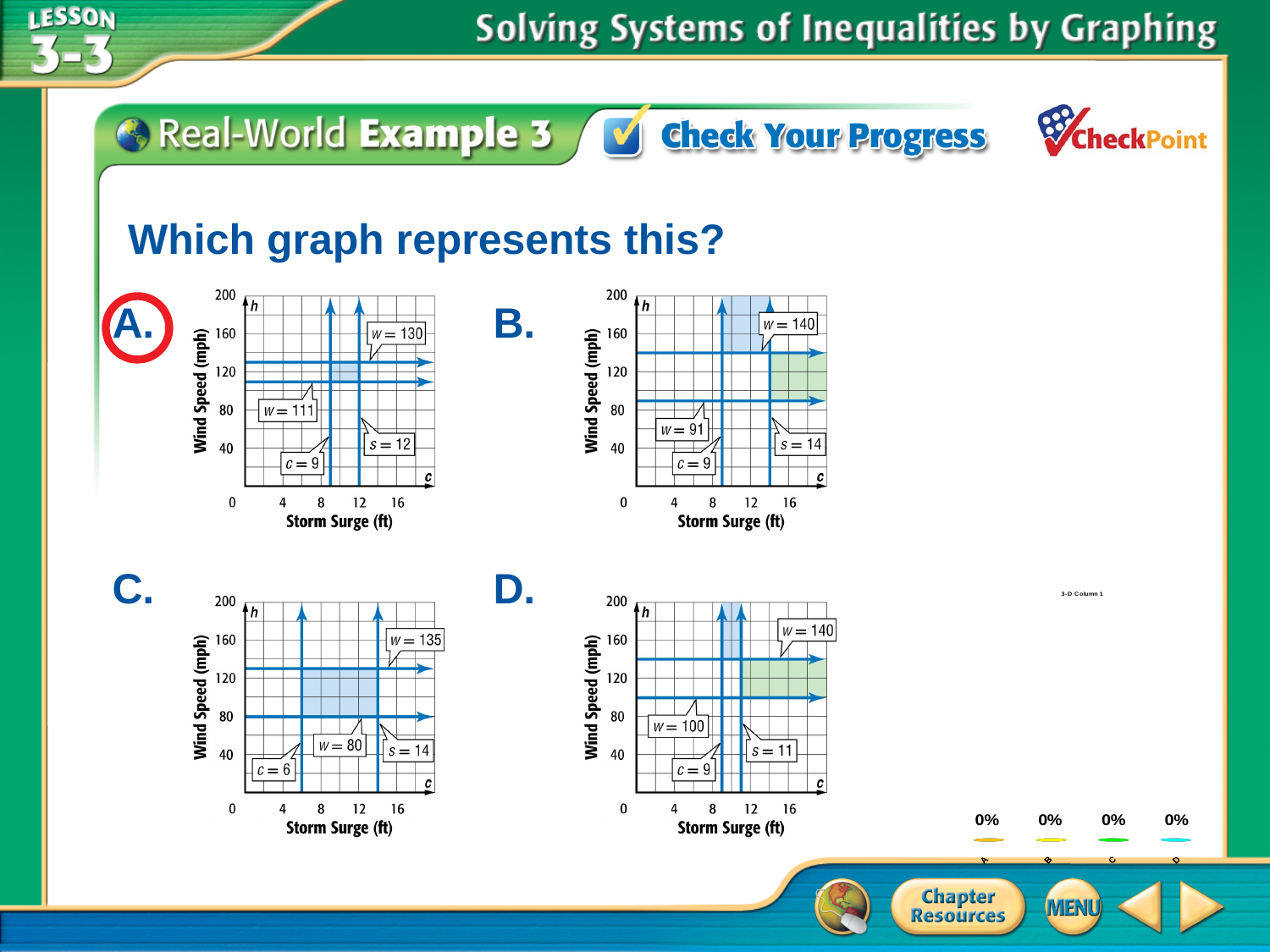
In graph D, what value of s is labeled on the right vertical line? 11 What is the label on the vertical axis of graph A? Wind Speed (mph) What is the title printed above the small bar chart at the bottom right? 3-D Column 1 In graph B, what value of s is labeled on the right vertical line? 14 In graph D, what value of w is labeled on the lower horizontal line? 100 In graph C, what value of c is labeled on the left vertical line? 6 In graph A, what value of w is labeled on the lower horizontal line? 111 In graph A, what value of w is labeled on the upper horizontal line? 130 In the small bar chart at the bottom right, what is the value shown for category A? 0% What kind of chart is the small chart at the bottom right of the slide? bar chart In the small bar chart at the bottom right, how many categories are shown? 4 In the small bar chart at the bottom right, what is the value shown for category D? 0%